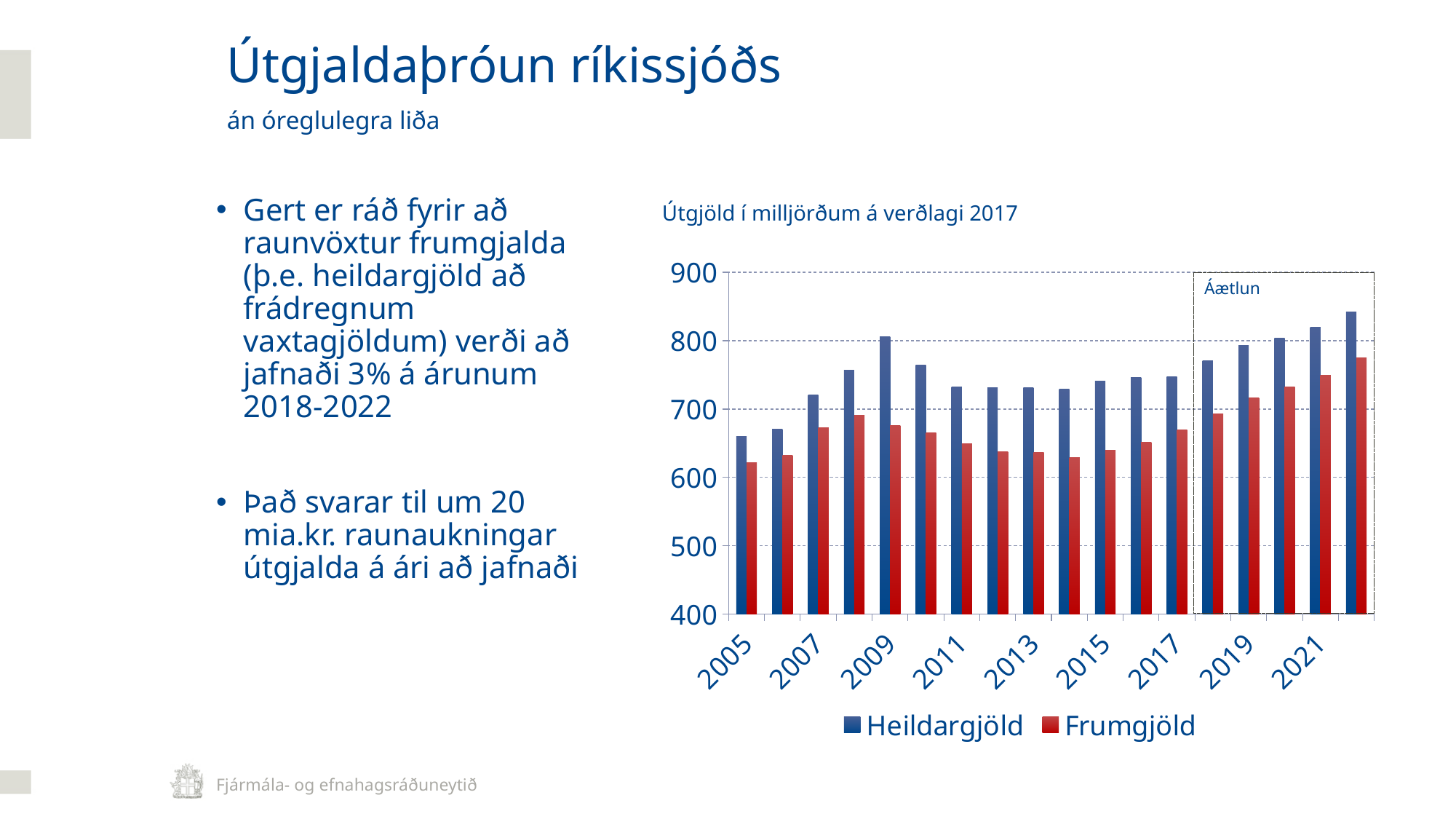
Is the Heildargjöld value for 2017 greater or less than 700? greater How many series does the chart legend list? 2 In which year is the Heildargjöld bar highest? 2022 In which year is the Heildargjöld bar lowest? 2005 Is the Frumgjöld value for 2005 greater or less than 700? less Is the Heildargjöld value for 2022 greater or less than 800? greater What kind of chart is shown on the slide? Bar chart Do the Heildargjöld values rise or fall from 2018 to 2022? rise What label appears inside the dashed box at the right of the chart? Áætlun What are the two series named in the chart legend? Heildargjöld and Frumgjöld In which year is the Frumgjöld bar highest? 2022 Which is larger, the Heildargjöld value for 2009 or for 2017? 2009